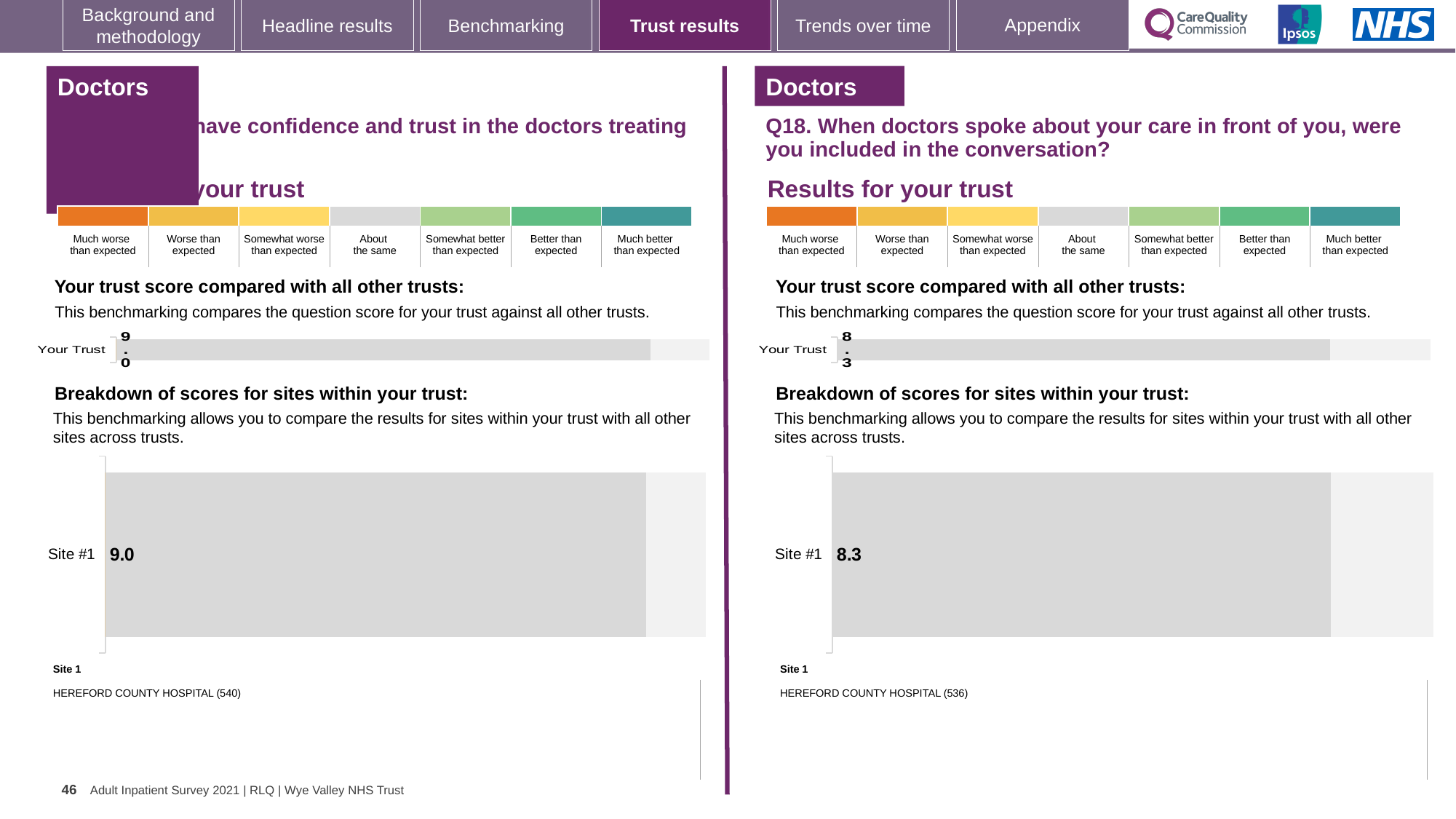
On the left-hand chart (the question about confidence and trust in the doctors treating you), what is the score shown for Your Trust? 9.0 Which hospital is listed as Site 1 beneath the left-hand site breakdown chart? HEREFORD COUNTY HOSPITAL (540) On the right-hand chart for Q18 ("When doctors spoke about your care in front of you, were you included in the conversation?"), what is the score shown for Your Trust? 8.3 Which hospital is listed as Site 1 beneath the right-hand Q18 site breakdown chart? HEREFORD COUNTY HOSPITAL (536) What type of chart is used to show the Site #1 score on the right-hand Q18 site breakdown? Bar chart On the right-hand Q18 site breakdown chart, what is the score for Site #1? 8.3 What is the difference between the Your Trust score on the left-hand chart and the Your Trust score on the right-hand Q18 chart? 0.7 Is the Your Trust score on the right-hand Q18 chart greater or less than the Your Trust score on the left-hand chart? less Which is larger: the Site #1 score on the left-hand site breakdown chart or the Site #1 score on the right-hand Q18 site breakdown chart? The left-hand chart (9.0) On the left-hand site breakdown chart, what is the score for Site #1? 9.0 How many sites are shown in the right-hand Q18 site breakdown chart? 1 How many sites are shown in the left-hand site breakdown chart? 1